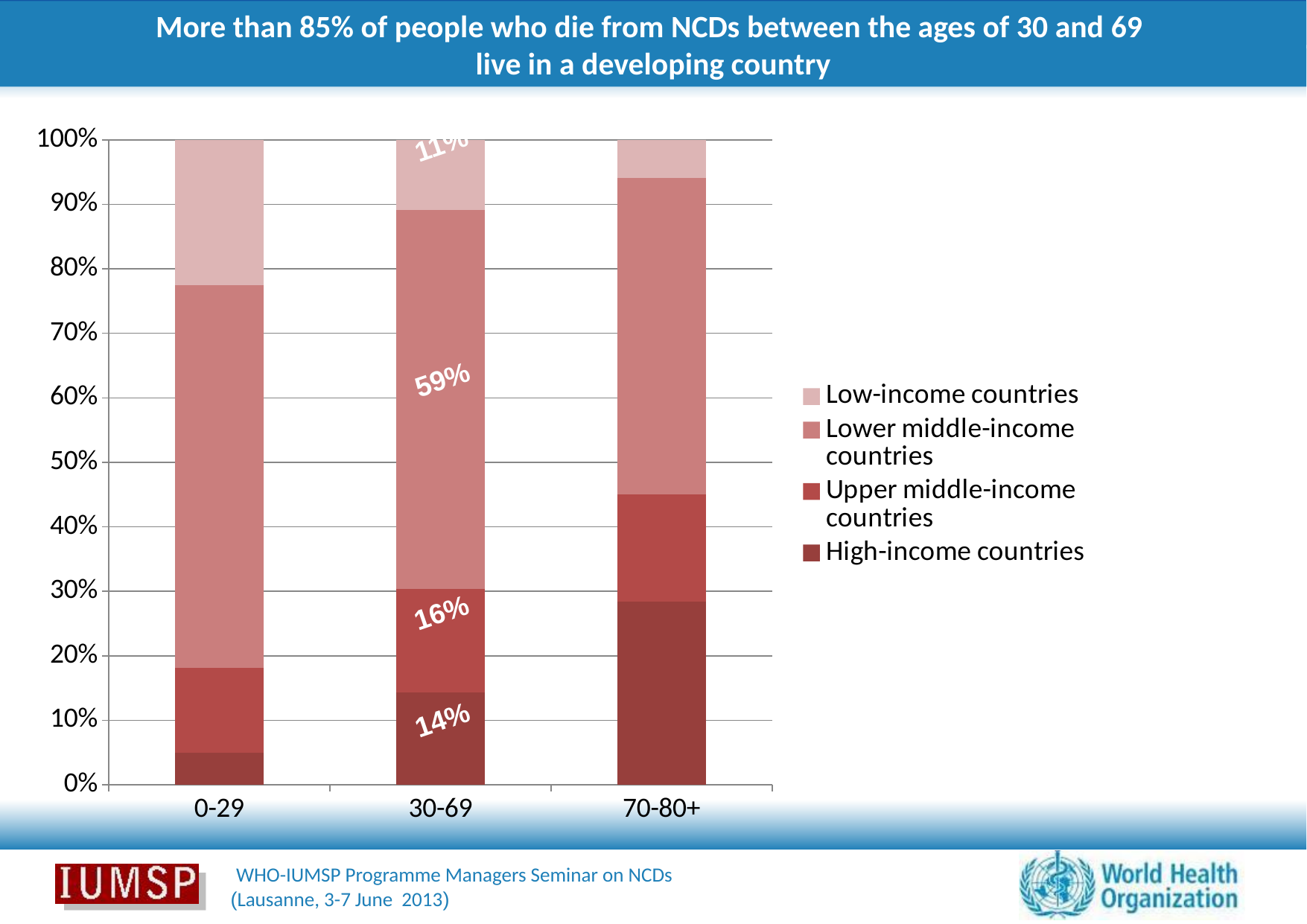
In the 30-69 age group, which income group has the largest share? Lower middle-income countries In the 30-69 age group, which income group has the smallest share? Low-income countries How many age groups are shown on the x axis? 3 How many series does the legend list? 4 Is the High-income countries share in the 0-29 age group greater or less than 10%? less What is the labelled value for Upper middle-income countries in the 30-69 age group? 16% Which age group has the larger High-income countries share, 0-29 or 70-80+? 70-80+ What is the labelled value for Low-income countries in the 30-69 age group? 11% Is the High-income countries share in the 70-80+ age group greater or less than 20%? greater In the 30-69 age group, how many percentage points larger is the Lower middle-income share than the Upper middle-income share? 43 percentage points What is the labelled value for High-income countries in the 30-69 age group? 14% What percentage of the 30-69 bar is labelled for Lower middle-income countries? 59%